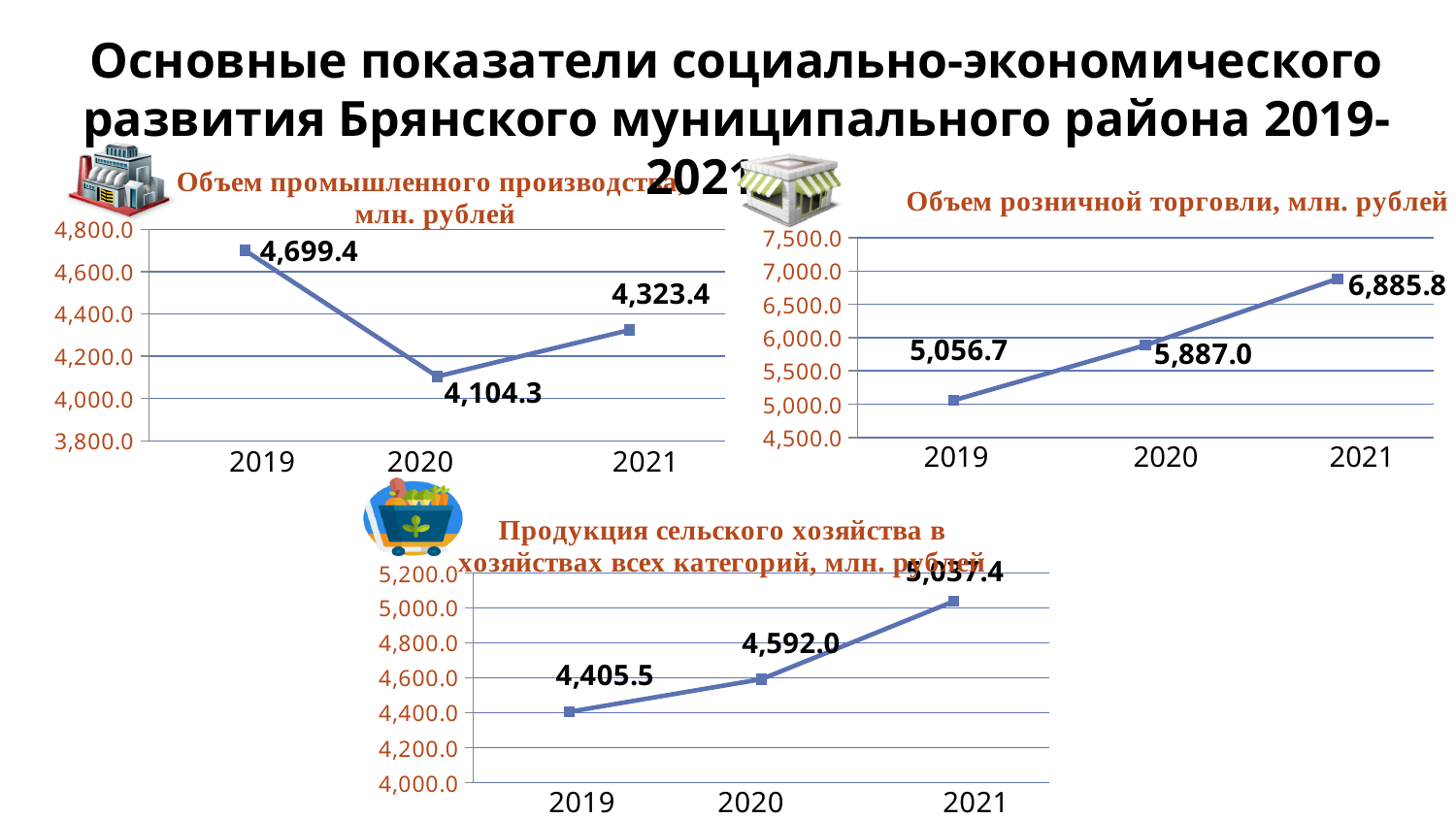
In the chart 'Объем промышленного производства, млн. рублей', which year has the lowest value? 2020 In the chart 'Продукция сельского хозяйства в хозяйствах всех категорий, млн. рублей', what is the value for 2020? 4,592.0 In the chart 'Объем промышленного производства, млн. рублей', what is the value for 2019? 4,699.4 What type of chart is 'Продукция сельского хозяйства в хозяйствах всех категорий, млн. рублей'? line chart In the chart 'Продукция сельского хозяйства в хозяйствах всех категорий, млн. рублей', is the value for 2019 greater or less than 4,600.0? less How many data points are plotted in the chart 'Объем розничной торговли, млн. рублей'? 3 In the chart 'Объем розничной торговли, млн. рублей', do the values rise or fall from 2019 to 2021? rise In the chart 'Объем промышленного производства, млн. рублей', what is the difference between the 2019 and 2020 values? 595.1 In the chart 'Продукция сельского хозяйства в хозяйствах всех категорий, млн. рублей', which year has the highest value? 2021 In the chart 'Объем промышленного производства, млн. рублей', which is larger: the value for 2020 or the value for 2021? 2021 In the chart 'Объем розничной торговли, млн. рублей', what is the difference between the 2021 and 2019 values? 1,829.1 In the chart 'Объем розничной торговли, млн. рублей', what is the value for 2021? 6,885.8